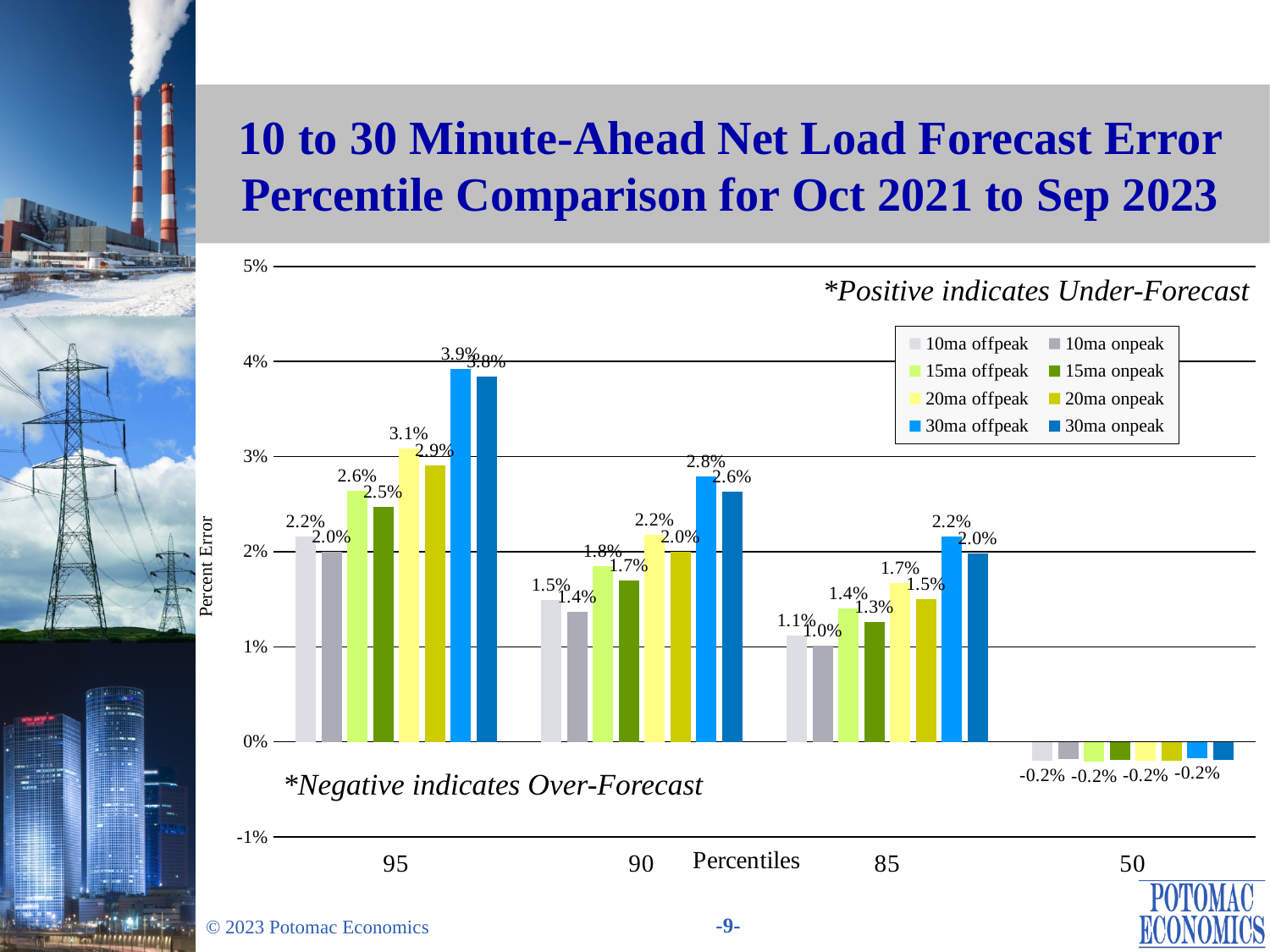
Which series has the highest value at the 95th percentile? 30ma offpeak What kind of chart is shown on the slide? bar chart Is the value for 30ma offpeak at the 50th percentile greater or less than 0%? less What is the difference between the 30ma offpeak and 10ma offpeak values at the 95th percentile? 1.7% At the 90th percentile, which is larger: 20ma offpeak or 30ma onpeak? 30ma onpeak What is the value for 20ma onpeak at the 85th percentile? 1.5% How many percentile categories are shown on the x axis? 4 What is the value for 30ma offpeak at the 95th percentile? 3.9% Which series has the lowest value at the 85th percentile? 10ma onpeak What is the value for 10ma offpeak at the 90th percentile? 1.5% How many series does the legend list? 8 What is the value for 15ma onpeak at the 90th percentile? 1.7%